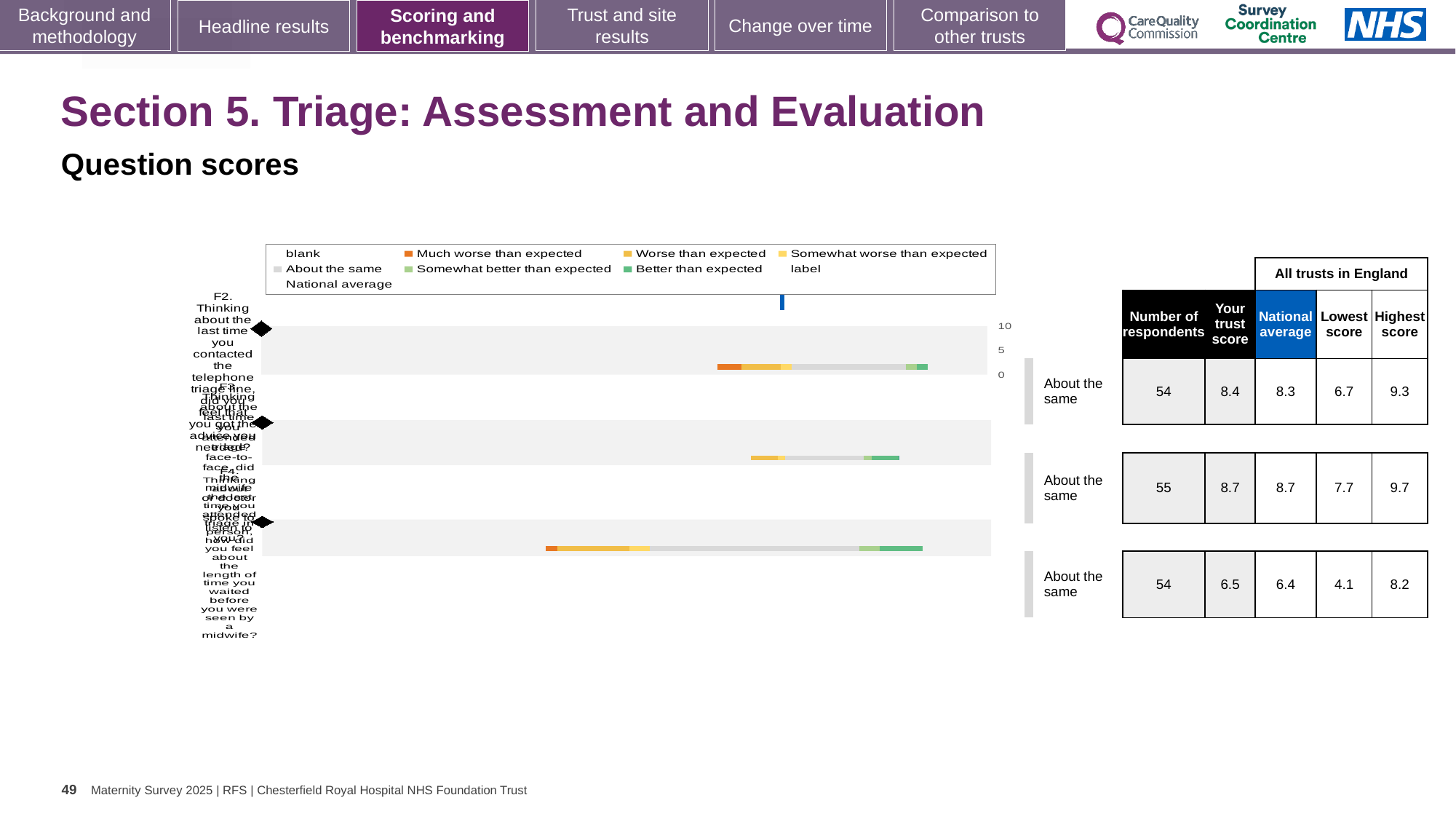
What is the national average for the second question row in the chart? 8.7 In the chart legend, what colour represents 'Much worse than expected'? orange Which question row has the highest 'Your trust score'? the second row (8.7) What is the 'Your trust score' value for the top question row in the chart? 8.4 What benchmark category is shown next to each of the three question rows? About the same For the bottom question row, what is the difference between the highest score and the lowest score across all trusts in England? 4.1 Which question row has the lowest 'Your trust score'? the bottom row (6.5) What kind of chart is shown on the slide? bar chart For the top question row, which is larger: the trust score or the national average? the trust score (8.4) How many respondents are listed for the second question row? 55 What is the lowest score across all trusts in England for the bottom question row? 4.1 How many question rows (bars) are plotted in the chart? 3